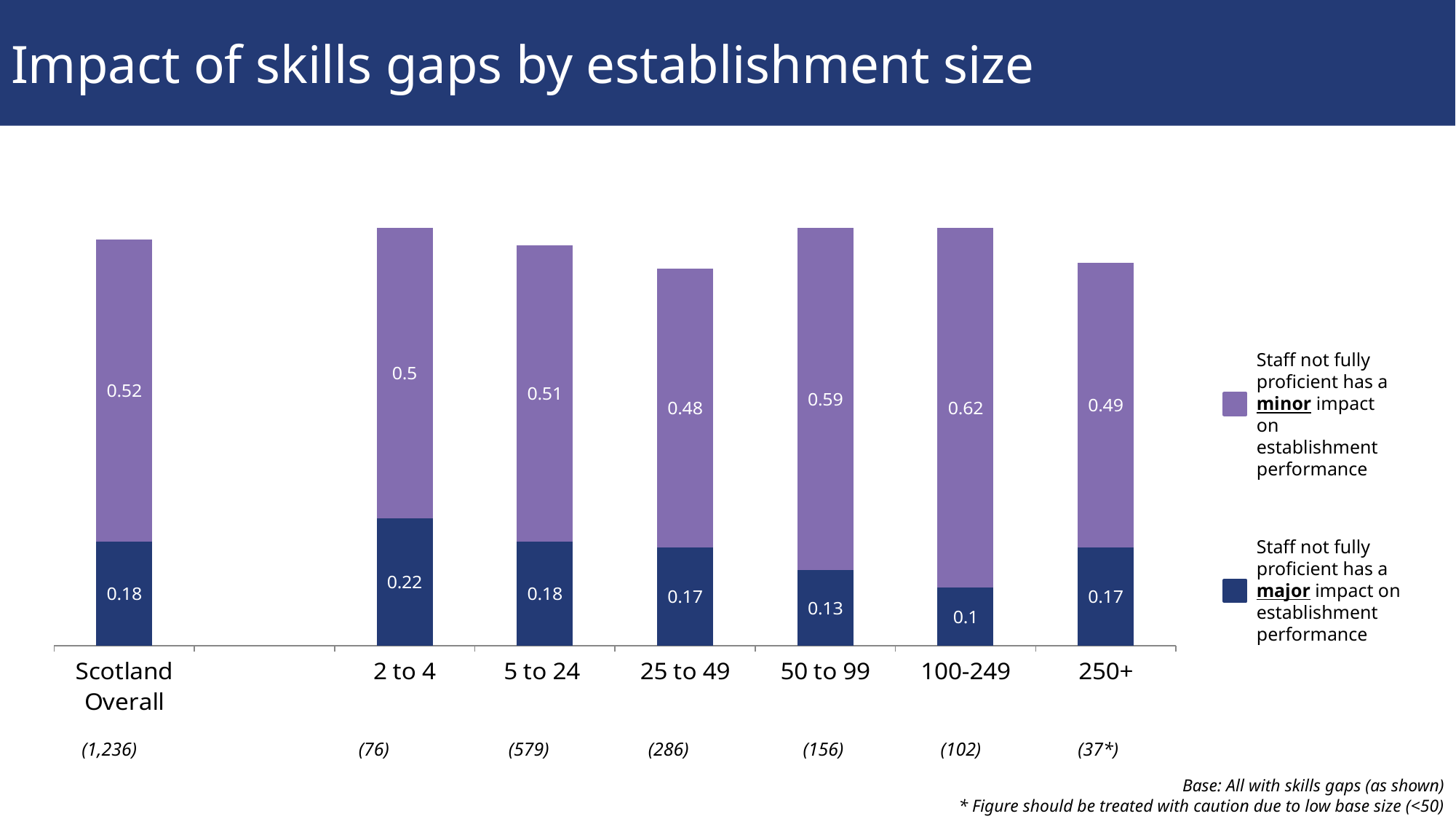
What is the minor impact value for Scotland Overall? 0.52 What is the value for 'Staff not fully proficient has a major impact on establishment performance' for the 2 to 4 establishment size? 0.22 What is the total of the stacked bar for the 25 to 49 establishment size? 0.65 How many establishment size categories are shown on the x axis? 7 Which is larger: the major impact value for 2 to 4 or the major impact value for 50 to 99? 2 to 4 Which establishment size has the highest value for minor impact on establishment performance? 100-249 What kind of chart is shown on the slide? Stacked bar chart What is the value for 'Staff not fully proficient has a minor impact on establishment performance' for the 50 to 99 establishment size? 0.59 Do the major impact values rise or fall from the 2 to 4 category to the 100-249 category? Fall What is the difference between the minor impact value and the major impact value for the 100-249 establishment size? 0.52 Which establishment size has the lowest value for major impact on establishment performance? 100-249 How many series does the legend list? 2